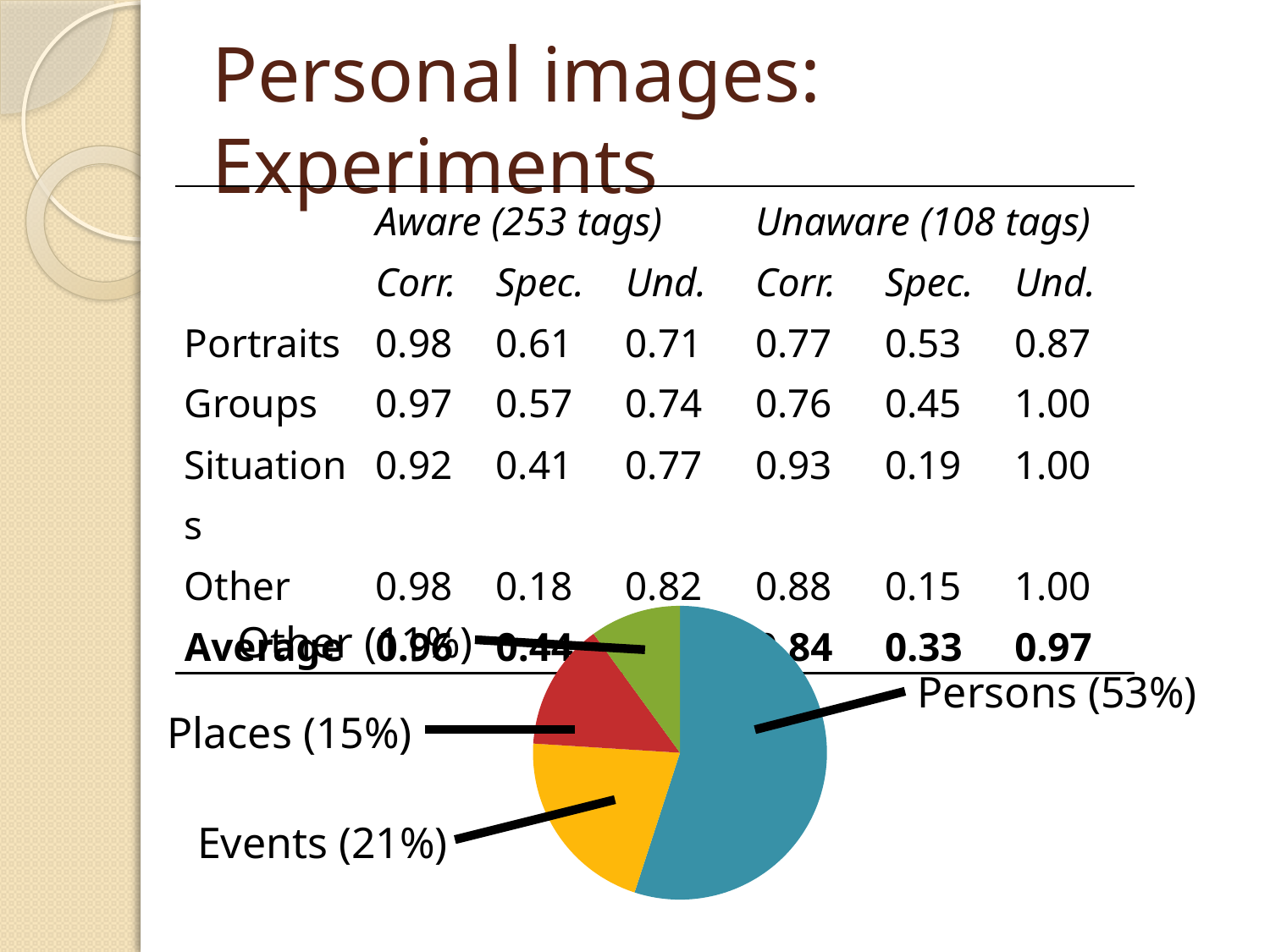
Which is larger, the Events slice or the Places slice? Events What colour is the Persons slice of the pie? blue What is the difference in percentage points between Events and Places? 6 What share of the pie does Places have? 15% Which category has the largest slice of the pie? Persons What kind of chart is shown on the slide? pie chart Does Persons account for more or less than half of the pie? more What colour is the Events slice of the pie? orange What share of the pie does Events have? 21% How many slices does the pie chart have? 4 What is the difference in percentage points between Persons and Events? 32 What share of the pie does Persons have? 53%